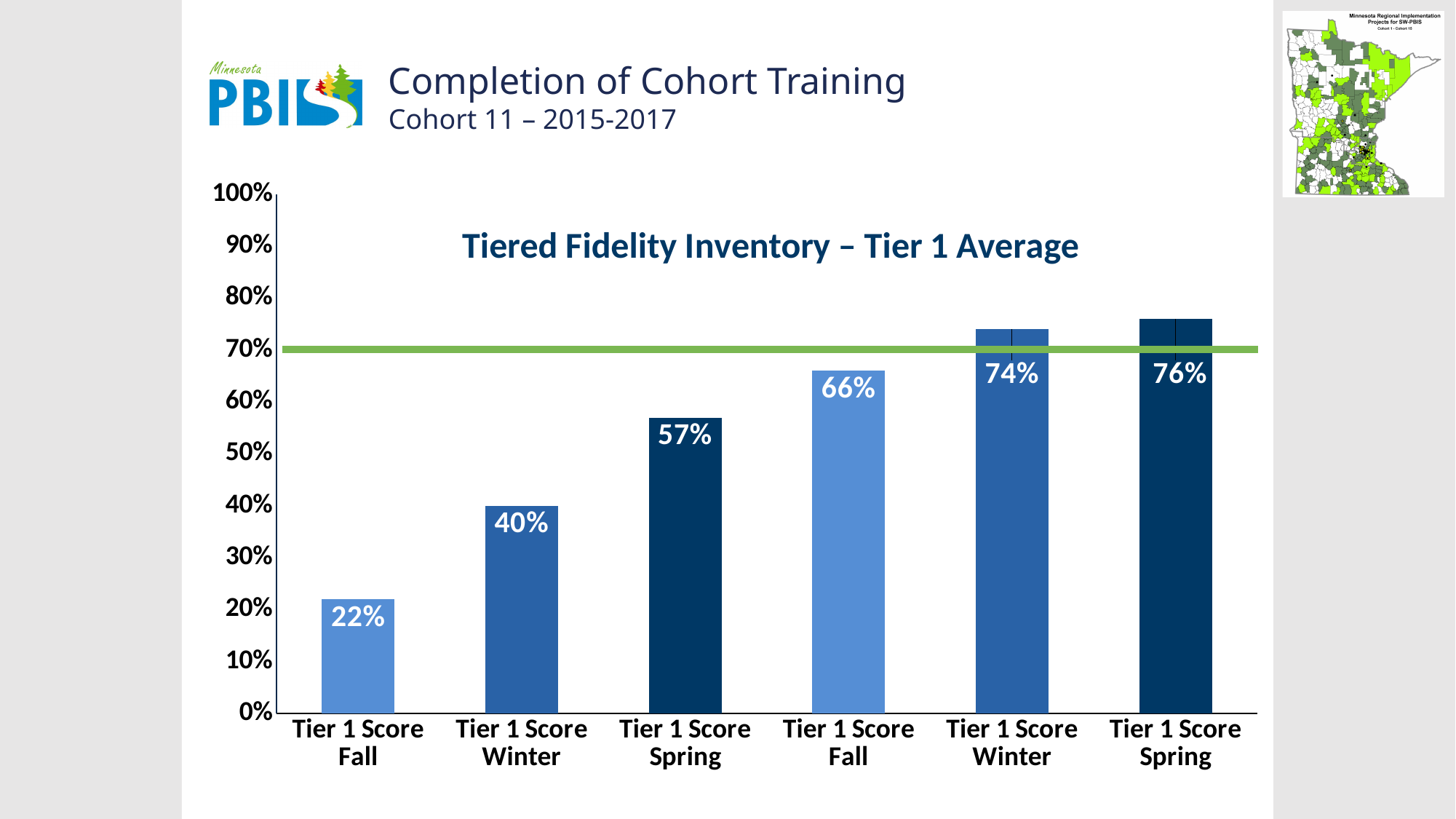
What is the value of the first Tier 1 Score Spring bar (third from left)? 57% Do the values rise or fall from left to right across the bars? rise How many bars are plotted in the chart? 6 What is the value of the second Tier 1 Score Fall bar (fourth from left)? 66% What is the value of the rightmost bar, the second Tier 1 Score Spring? 76% What type of chart is shown on the slide? bar chart What is the value of the first bar, Tier 1 Score Fall (leftmost)? 22% What is the chart's title? Tiered Fidelity Inventory – Tier 1 Average Which is larger: the first Tier 1 Score Spring bar (third from left) or the second Tier 1 Score Fall bar (fourth from left)? the second Tier 1 Score Fall bar (66%) What is the difference between the rightmost Tier 1 Score Spring bar (76%) and the leftmost Tier 1 Score Fall bar (22%)? 54% Which bar has the lowest value? Tier 1 Score Fall (leftmost bar) What is the value of the first Tier 1 Score Winter bar (second from left)? 40%